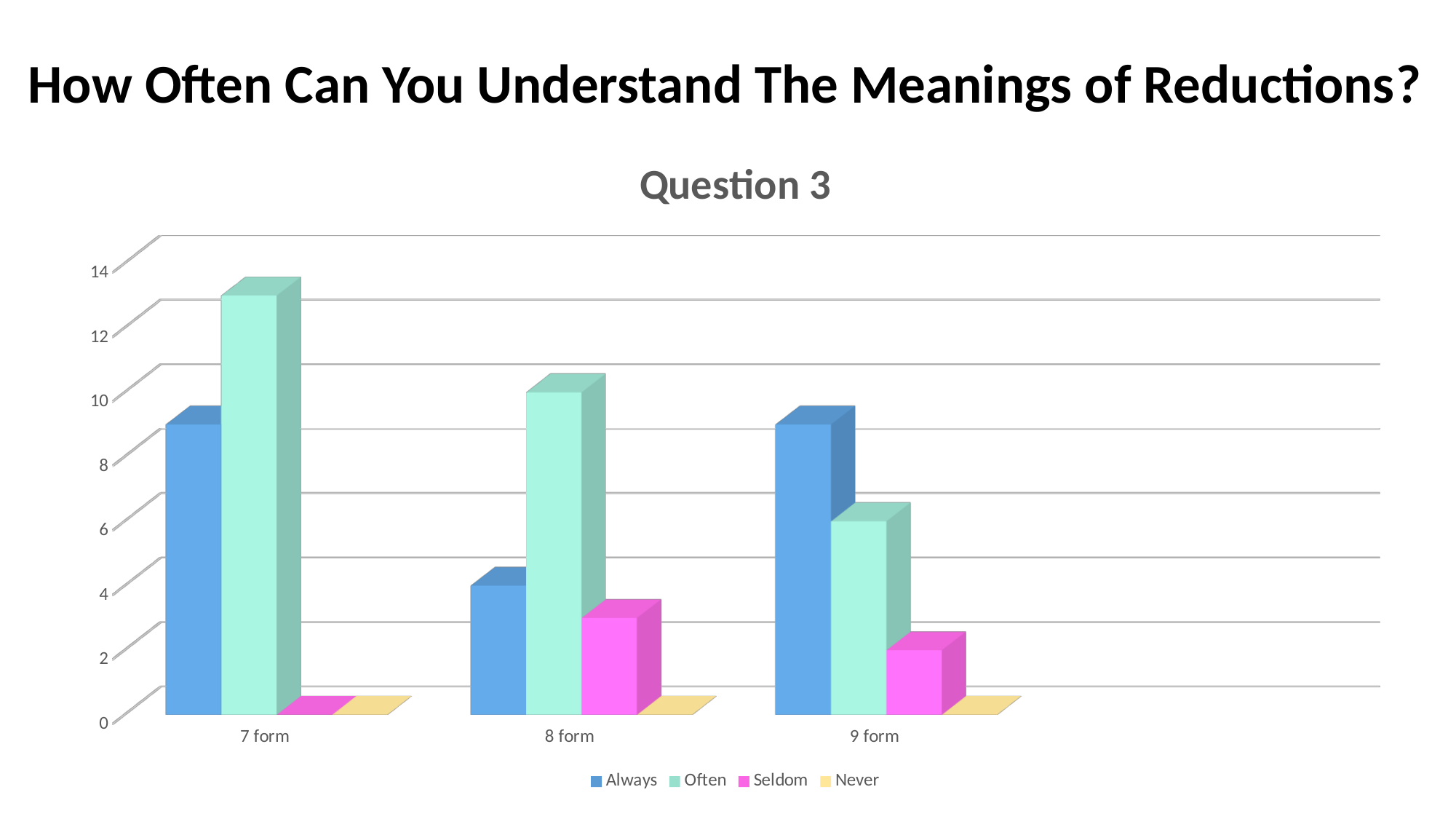
Which series is shown in pink in the legend? Seldom Which form has the highest value for Often? 7 form How many form categories are shown on the x axis? 3 Which series has the lowest value for 8 form? Never Is the value for Always in 8 form greater or less than 6? less Which series has the highest value for 8 form? Often What kind of chart is shown on the slide? Bar chart How many series does the legend list? 4 Is the value for Seldom in 9 form greater or less than 4? less Is the value for Often in 7 form greater or less than 12? greater For 9 form, which is larger, Always or Often? Always What is the title of the chart? Question 3